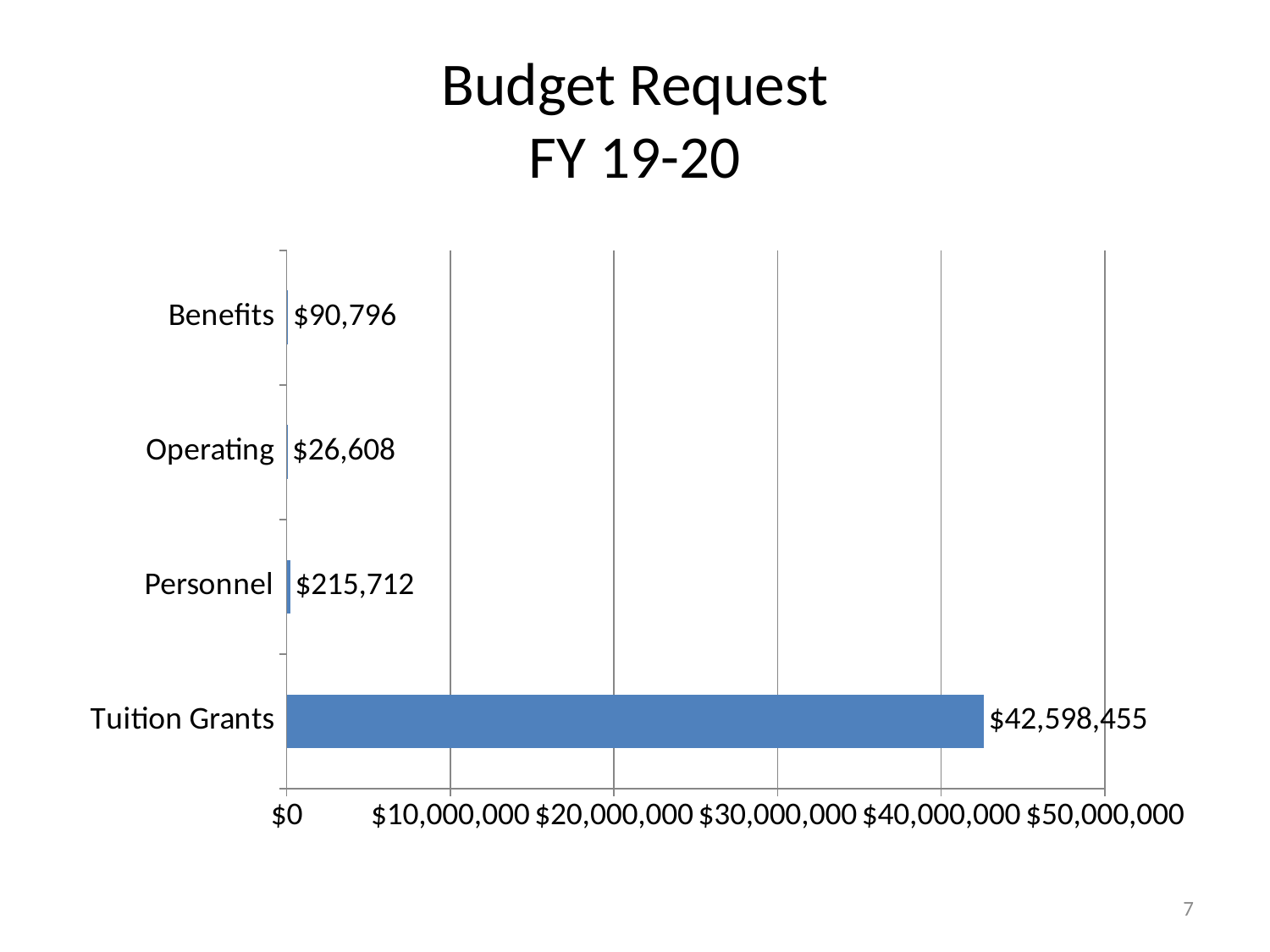
What is the difference between the Benefits and Operating values? $64,188 Is the value for Tuition Grants greater or less than $40,000,000? greater What is the value for Operating? $26,608 Which category has the highest value? Tuition Grants Which is larger, the value for Personnel or the value for Benefits? Personnel What is the difference between the Personnel and Benefits values? $124,916 What is the value for Personnel? $215,712 How many categories are shown in the chart? 4 Which category has the lowest value? Operating What is the value for Tuition Grants? $42,598,455 What is the value for Benefits? $90,796 What kind of chart is shown on the slide? bar chart